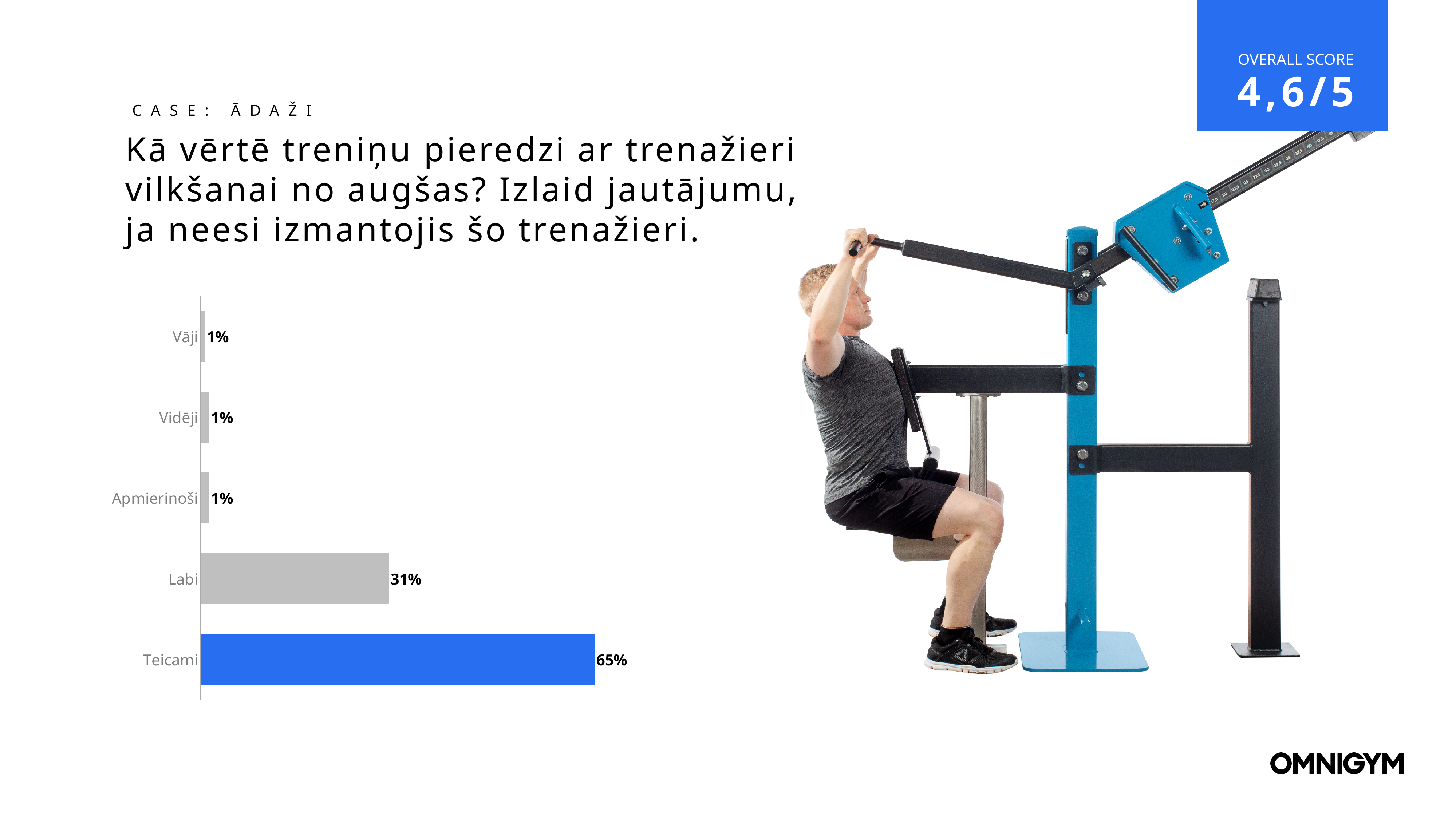
Which bar is coloured blue? Teicami What is the value for Vāji? 1% What is the difference between the values for Teicami and Labi? 34% What is the value for Labi? 31% How many categories have a value of 1%? 3 What is the value for Teicami? 65% What is the value for Apmierinoši? 1% How many categories does the chart show? 5 What overall score is shown on the slide? 4,6/5 Which is larger, the value for Labi or the value for Vidēji? Labi Which category has the highest value? Teicami What kind of chart is shown on the slide? Bar chart